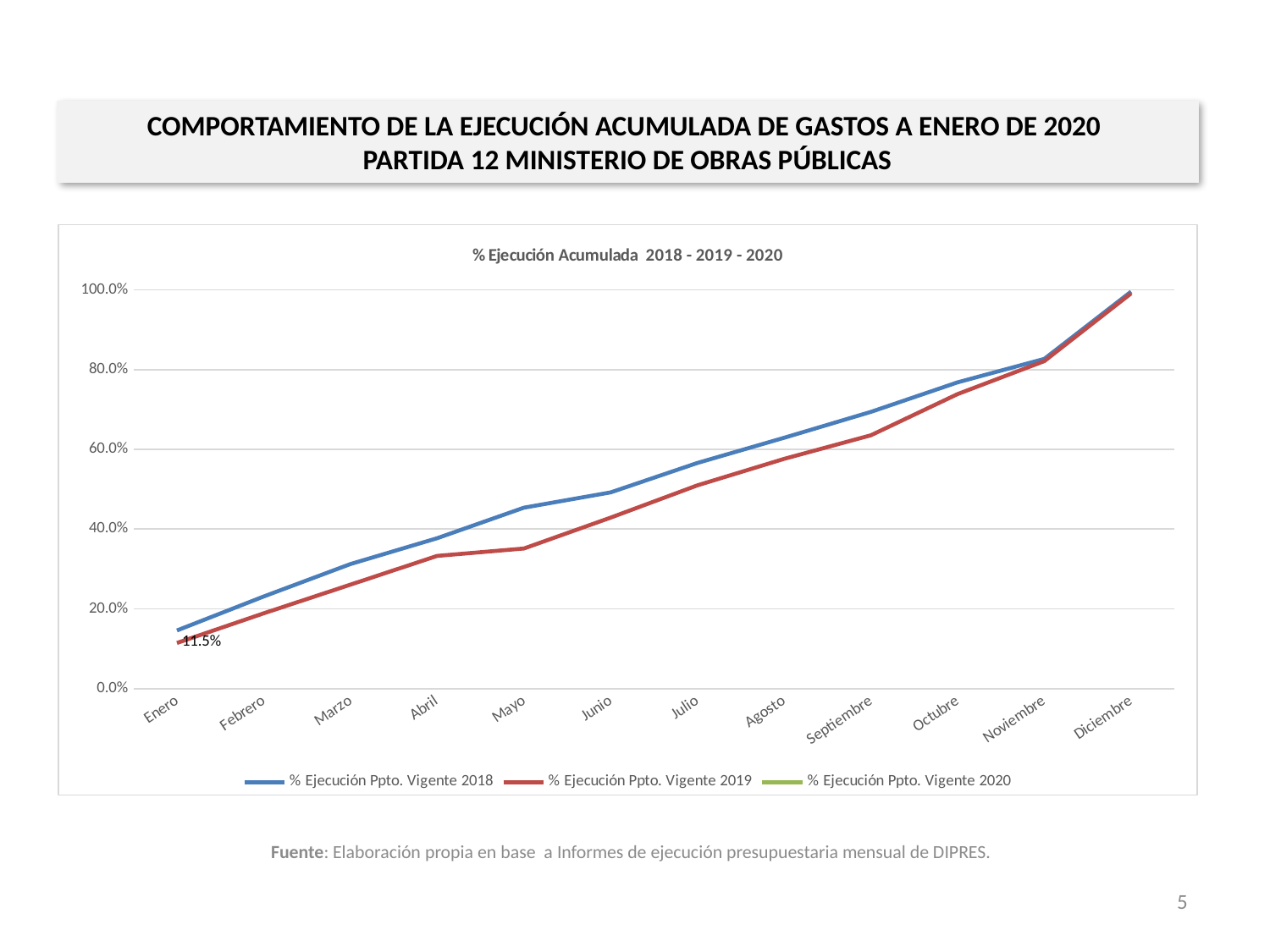
How many series does the legend list? 3 What data label value is printed at Enero? 11.5% In Mayo, which series has the higher value: % Ejecución Ppto. Vigente 2018 or % Ejecución Ppto. Vigente 2019? % Ejecución Ppto. Vigente 2018 How many months are shown along the x axis? 12 Do the values for % Ejecución Ppto. Vigente 2018 rise or fall from Enero to Diciembre? rise Is the value for % Ejecución Ppto. Vigente 2018 in Octubre greater or less than 80.0%? less Is the value for % Ejecución Ppto. Vigente 2019 in Septiembre greater or less than 60.0%? greater Is the value for % Ejecución Ppto. Vigente 2018 in Mayo greater or less than 40.0%? greater What is the title of the chart? % Ejecución Acumulada 2018 - 2019 - 2020 In which month does % Ejecución Ppto. Vigente 2018 reach its highest value? Diciembre What kind of chart is shown on the slide? line chart